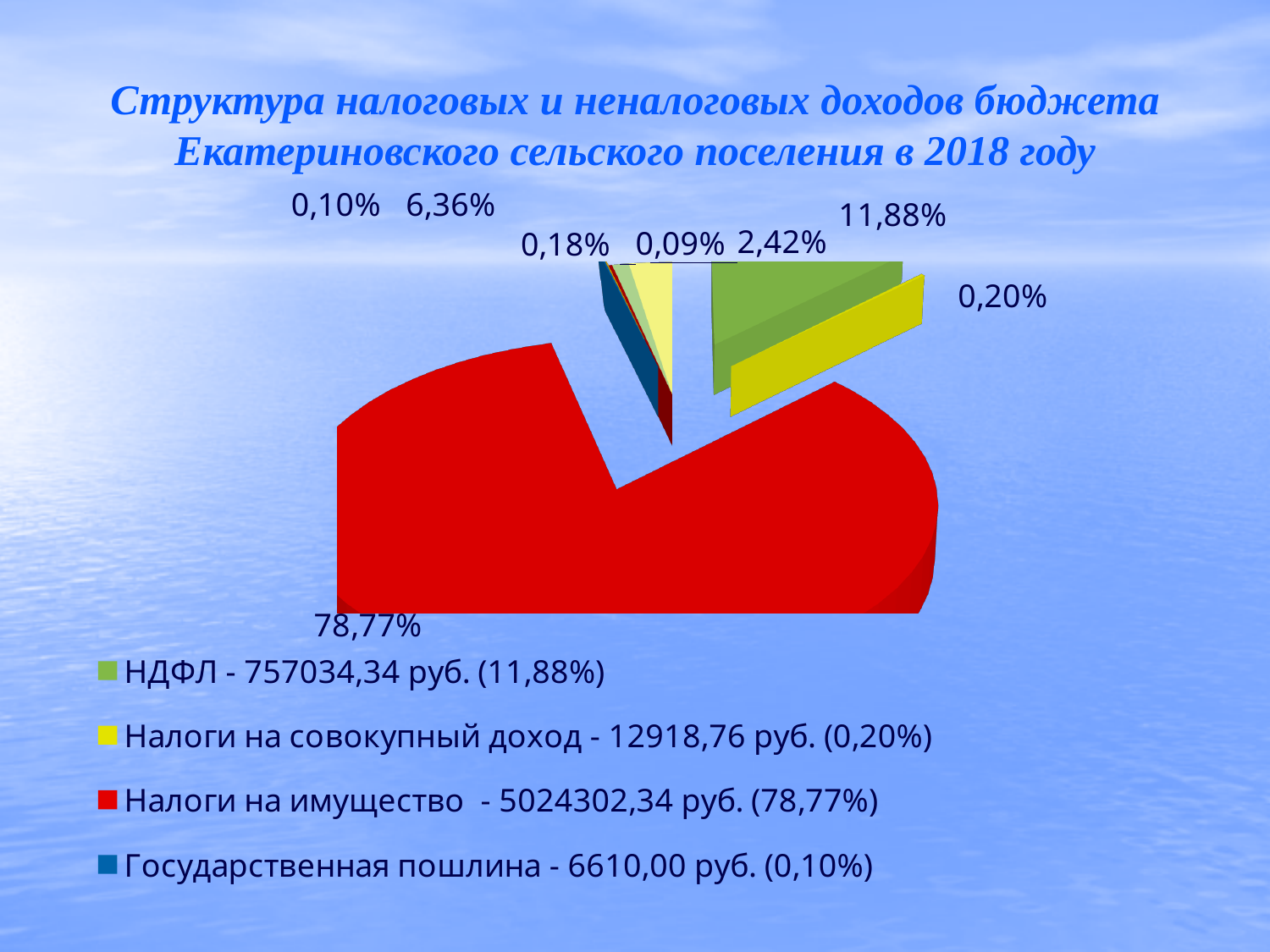
How many percentage data labels are shown on the pie chart? 8 What is the difference in percentage points between the Налоги на имущество slice and the НДФЛ slice? 66,89 Which is larger: the slice for НДФЛ or the slice for Налоги на совокупный доход? НДФЛ Which category has the largest slice of the pie? Налоги на имущество What share of the pie does the slice for НДФЛ have? 11,88% What amount in rubles is given in the legend for НДФЛ? 757034,34 руб. What share of the pie does the slice for Государственная пошлина have? 0,10% How many legend entries are listed below the chart? 4 What kind of chart is shown on the slide? pie chart What share of the pie does the slice for Налоги на имущество have? 78,77% What colour is the slice for Налоги на имущество? red